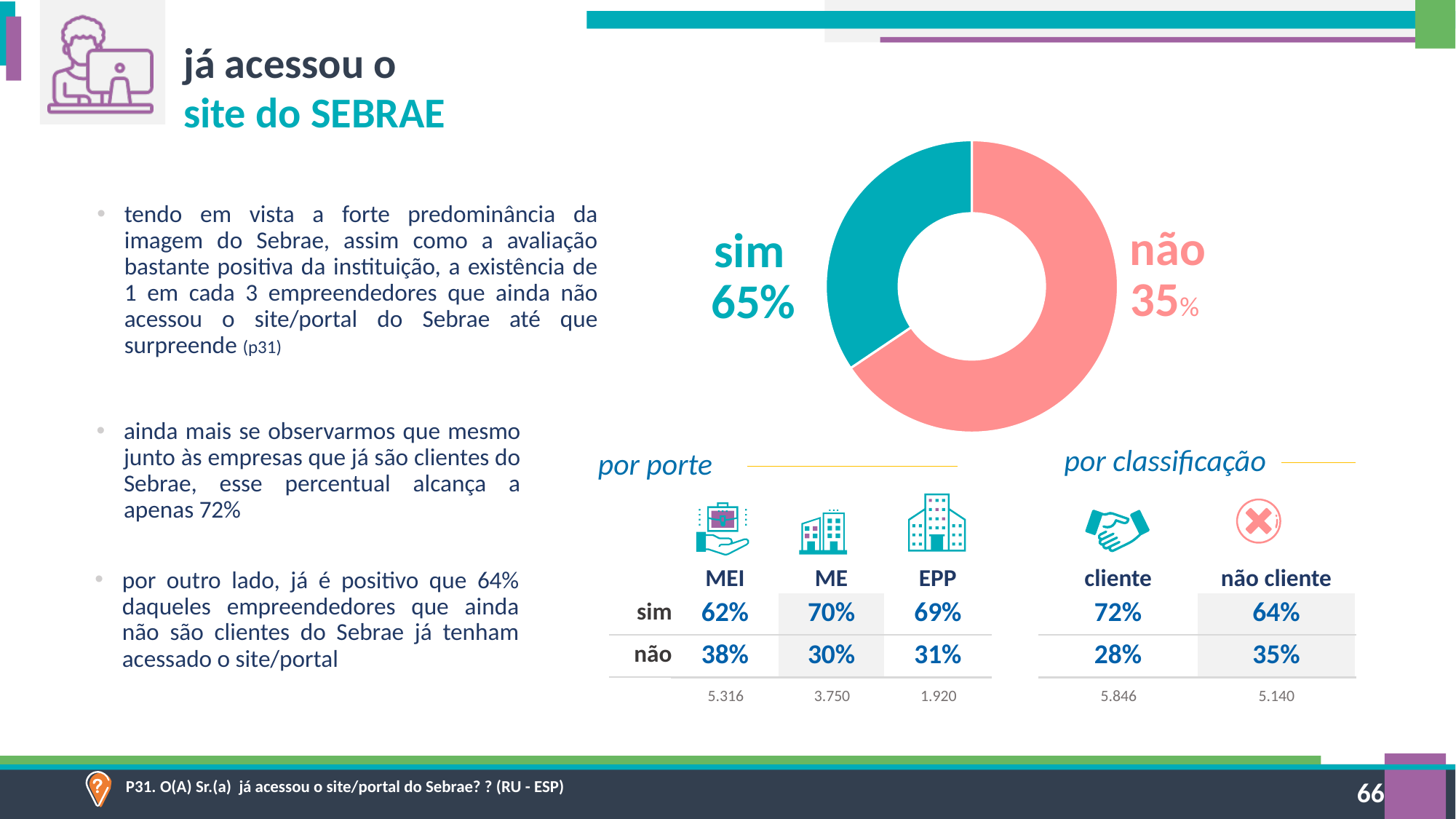
What colour is the "sim" slice of the pie chart? teal What is the difference in percentage points between the "sim" and "não" slices of the pie chart? 30 In the "por porte" table, what is the "sim" value for ME? 70% In the "por classificação" table, what is the "sim" value for cliente? 72% What kind of chart is shown on the slide? pie chart (donut) What share of the pie chart is labelled "não"? 35% How many slices does the pie chart have? 2 What colour is the "não" slice of the pie chart? pink/salmon What share of the pie chart is labelled "sim"? 65%